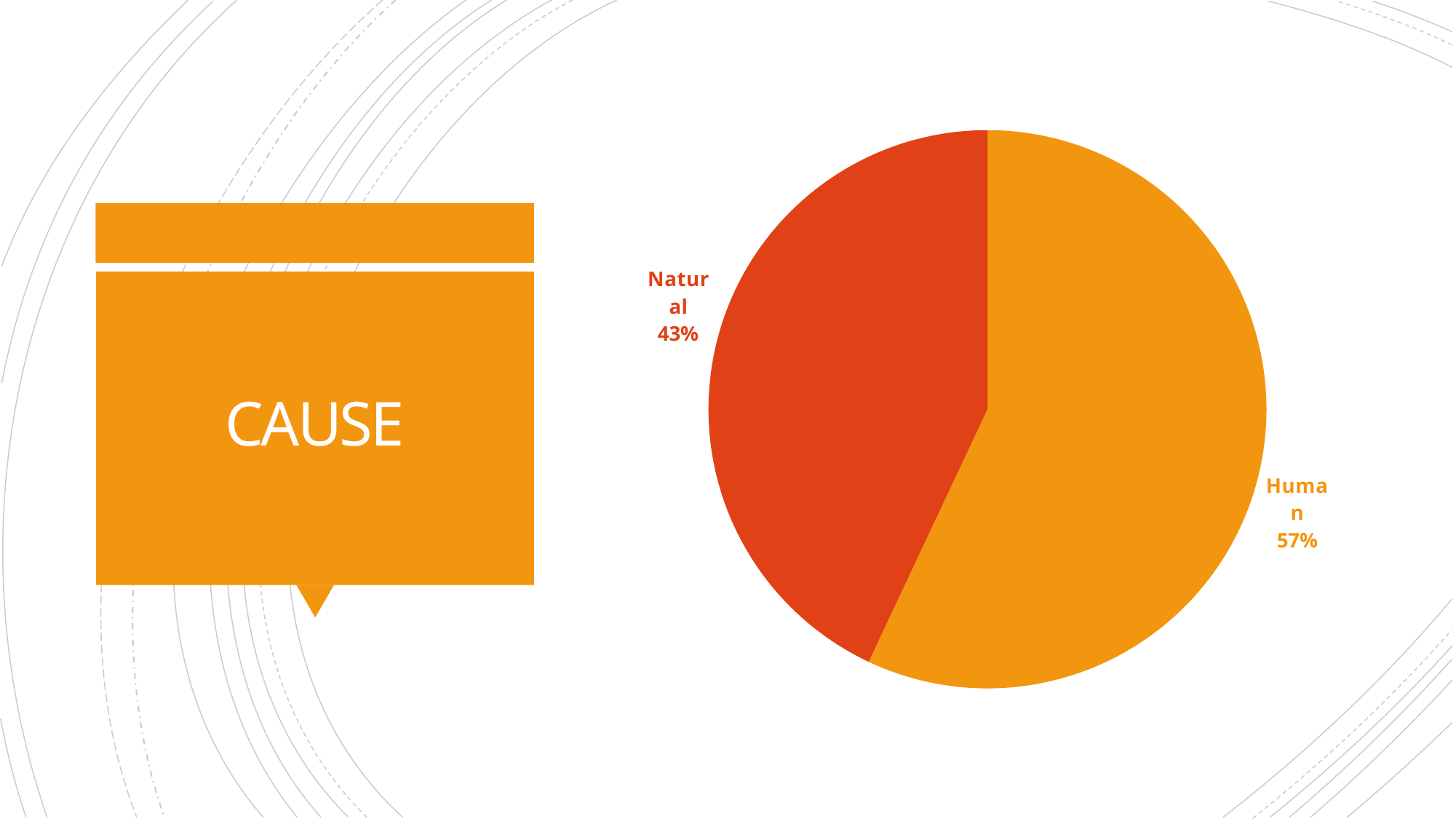
Which slice of the pie is the largest? Human What kind of chart is shown on the slide? pie chart What is the difference in percentage points between the Human and Natural slices? 14 Is the share for Natural greater or less than 50%? less What share of the pie does the Human slice represent? 57% What is the total of the two slice percentages shown? 100% What word appears in the text box to the left of the pie chart? CAUSE Which is larger, the Human slice or the Natural slice? Human How many slices does the pie chart have? 2 Which slice of the pie is the smallest? Natural Is the share for Human greater or less than 50%? greater What share of the pie does the Natural slice represent? 43%